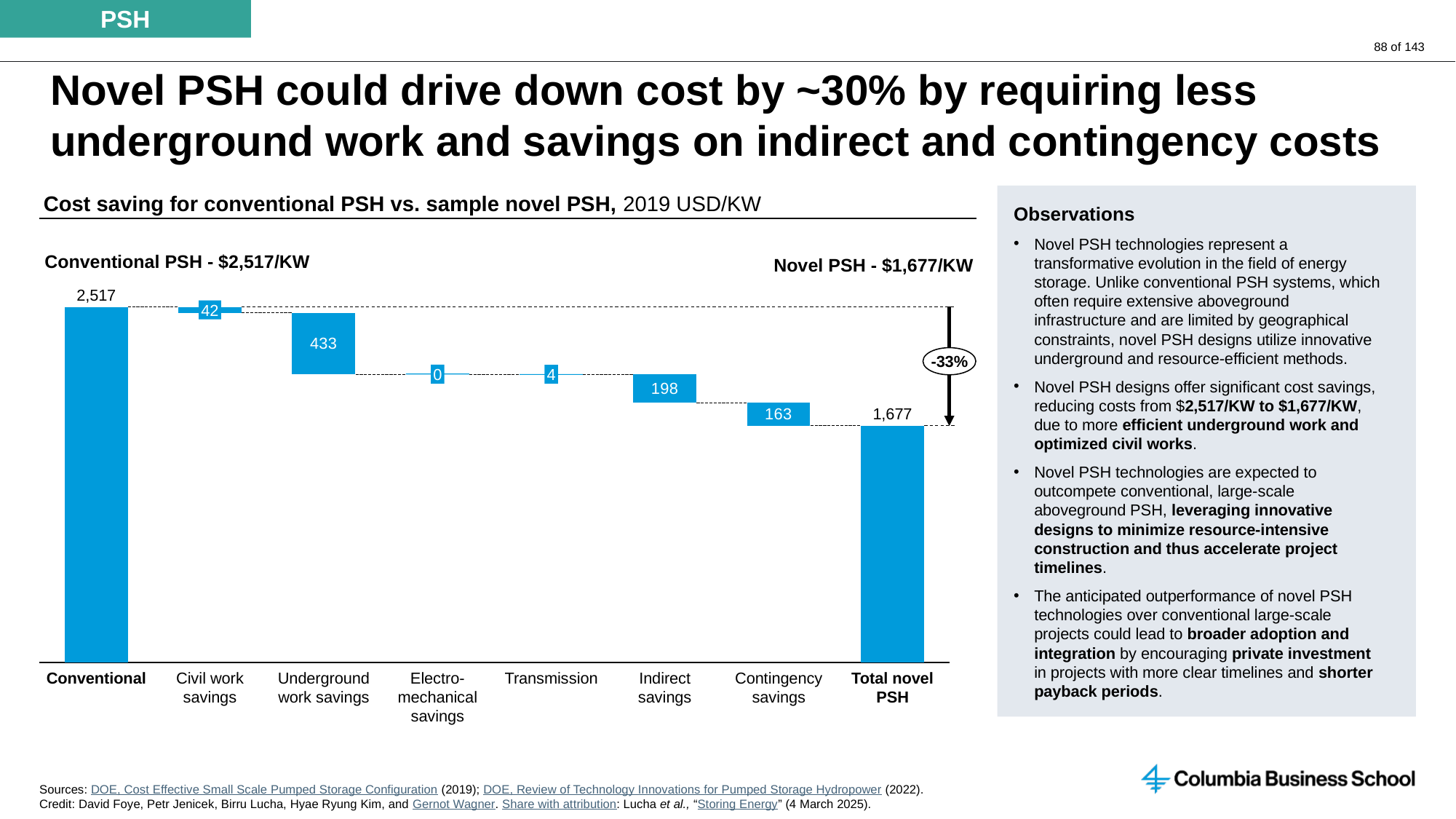
What percentage change is shown by the arrow on the right of the chart? -33% What unit is stated in the chart title? 2019 USD/KW What is the value for Indirect savings? 198 What is the value for Conventional in the cost saving chart? 2,517 What is the value for Total novel PSH? 1,677 What is the difference between the Conventional value and the Total novel PSH value? 840 What is the value for Underground work savings? 433 How many categories are shown on the x axis of the chart? 8 Which is larger, Indirect savings or Contingency savings? Indirect savings What is the value for Electro-mechanical savings? 0 What is the value for Contingency savings? 163 Which savings category contributes the largest saving? Underground work savings